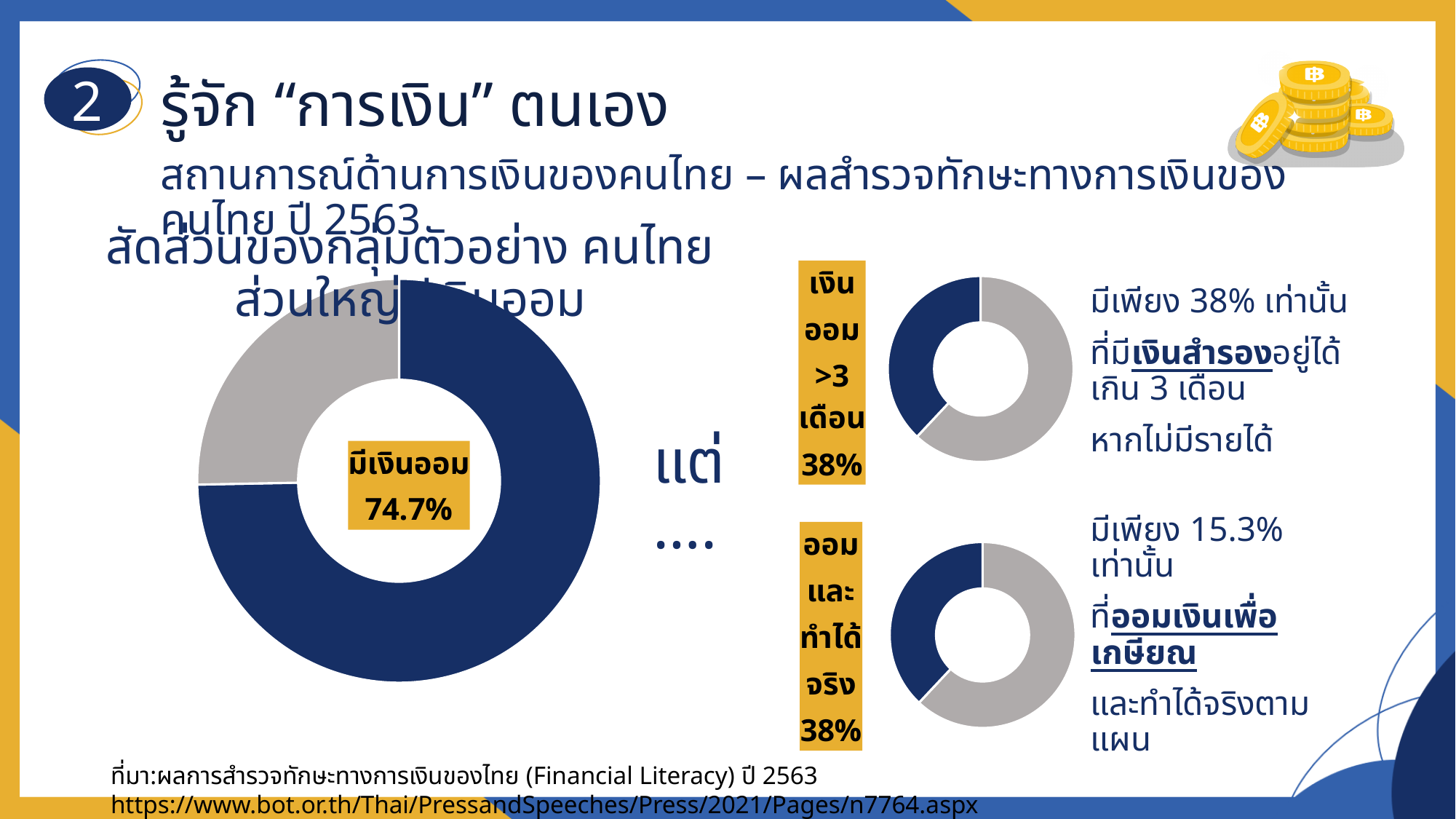
In the large chart on the left, which slice is larger, the dark blue one or the grey one? the dark blue one (มีเงินออม) What kind of chart is the large chart on the left of the slide? doughnut (pie) chart In the top-right small chart labelled เงินออม >3 เดือน, what percentage is shown? 38% How many doughnut charts are on the slide? 3 In the top-right small chart (เงินออม >3 เดือน), is the dark blue slice greater or less than 50%? less How many slices does the large chart on the left have? 2 What colour is the มีเงินออม slice in the large chart on the left? dark blue In the large chart on the left, what percentage is shown for มีเงินออม? 74.7% What is the difference between the มีเงินออม value in the large chart (74.7%) and the เงินออม >3 เดือน value in the top-right chart (38%)? 36.7 percentage points In the large chart on the left, what share does the grey slice represent, given มีเงินออม is 74.7%? 25.3% What is the label printed beside the top-right small chart? เงินออม >3 เดือน 38% In the large chart on the left, is the value for มีเงินออม greater or less than 50%? greater